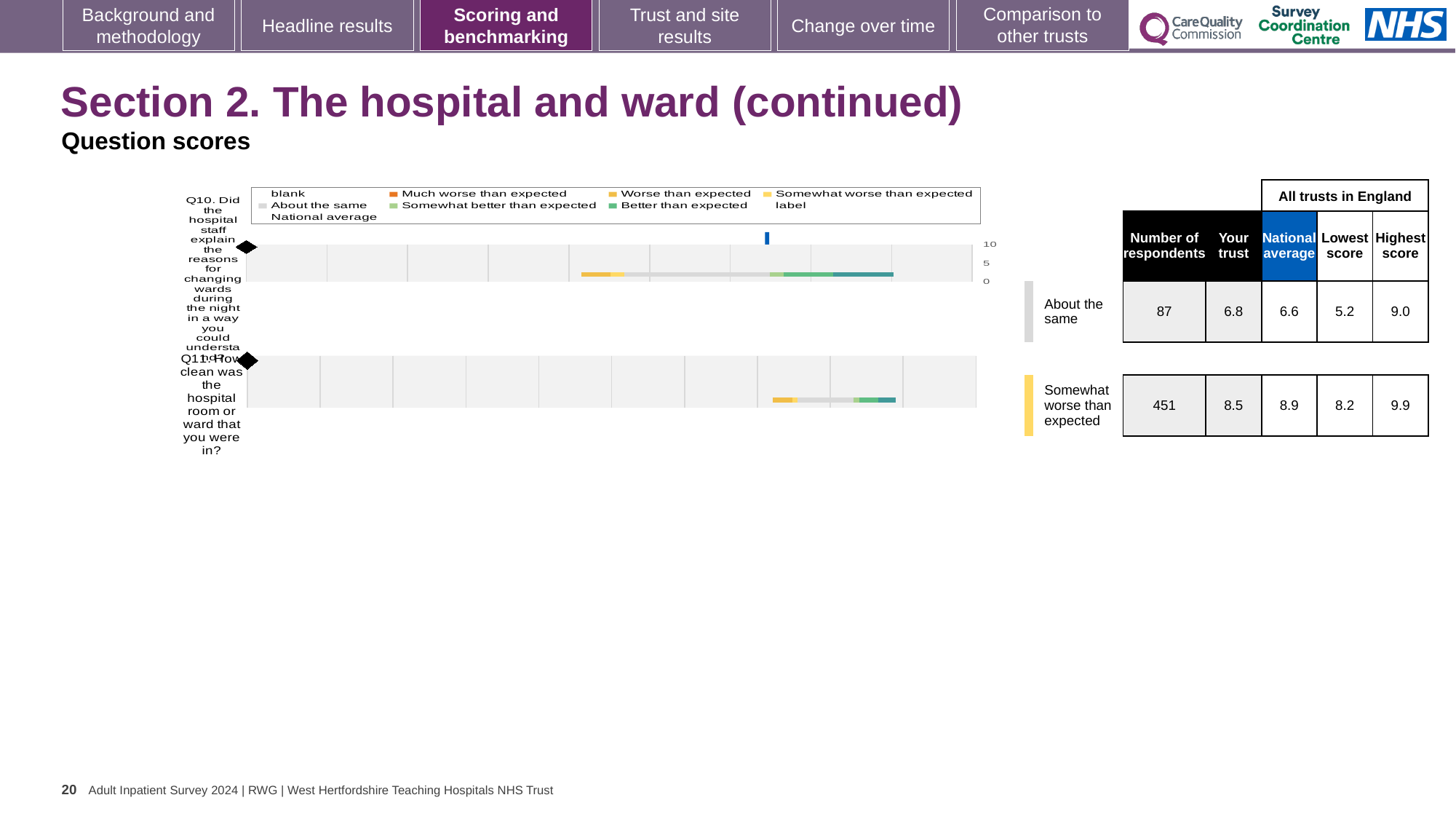
What is the maximum value shown on the chart's score axis? 10 Which benchmarking category is Q11 (how clean was the hospital room or ward) placed in? Somewhat worse than expected What is the difference between the highest score and the lowest score across all trusts for Q10? 3.8 Which question has the higher 'Your trust' score, Q10 or Q11? Q11 What is the national average for Q11 (how clean was the hospital room or ward)? 8.9 What is the difference between the national average and the trust score for Q11? 0.4 How many respondents answered Q10 (explaining reasons for changing wards during the night)? 87 What is the 'Your trust' score for Q10 (explaining reasons for changing wards during the night)? 6.8 Which legend entry is shown in orange, between 'blank' and 'Worse than expected'? Much worse than expected How many survey questions are plotted on the chart? 2 What is the 'Your trust' score for Q11 (how clean was the hospital room or ward)? 8.5 What kind of chart is shown on the slide? bar chart